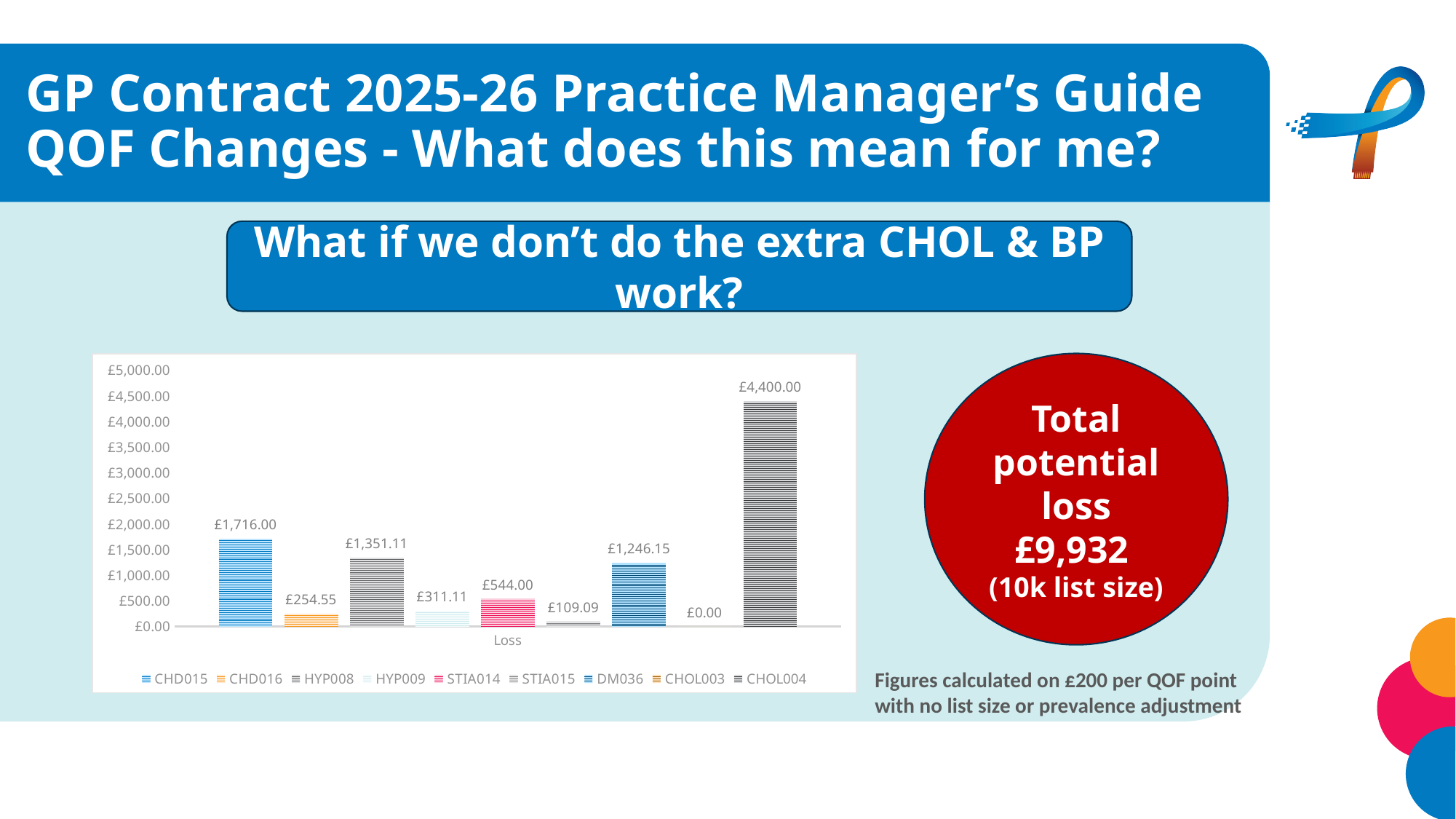
Which indicator has the highest loss value in the chart? CHOL004 How many series does the chart legend list? 9 What is the loss value shown for DM036? £1,246.15 What is the label on the horizontal axis of the chart? Loss Which has a larger loss value, HYP008 or DM036? HYP008 Is the loss value for STIA014 greater or less than £1,000.00? less What is the difference between the loss values for CHOL004 and CHD015? £2,684.00 What is the loss value shown for CHOL004? £4,400.00 What kind of chart is shown on the slide? bar chart What is the loss value shown for STIA015? £109.09 What is the loss value shown for CHD015? £1,716.00 Which indicator has the lowest loss value in the chart? CHOL003